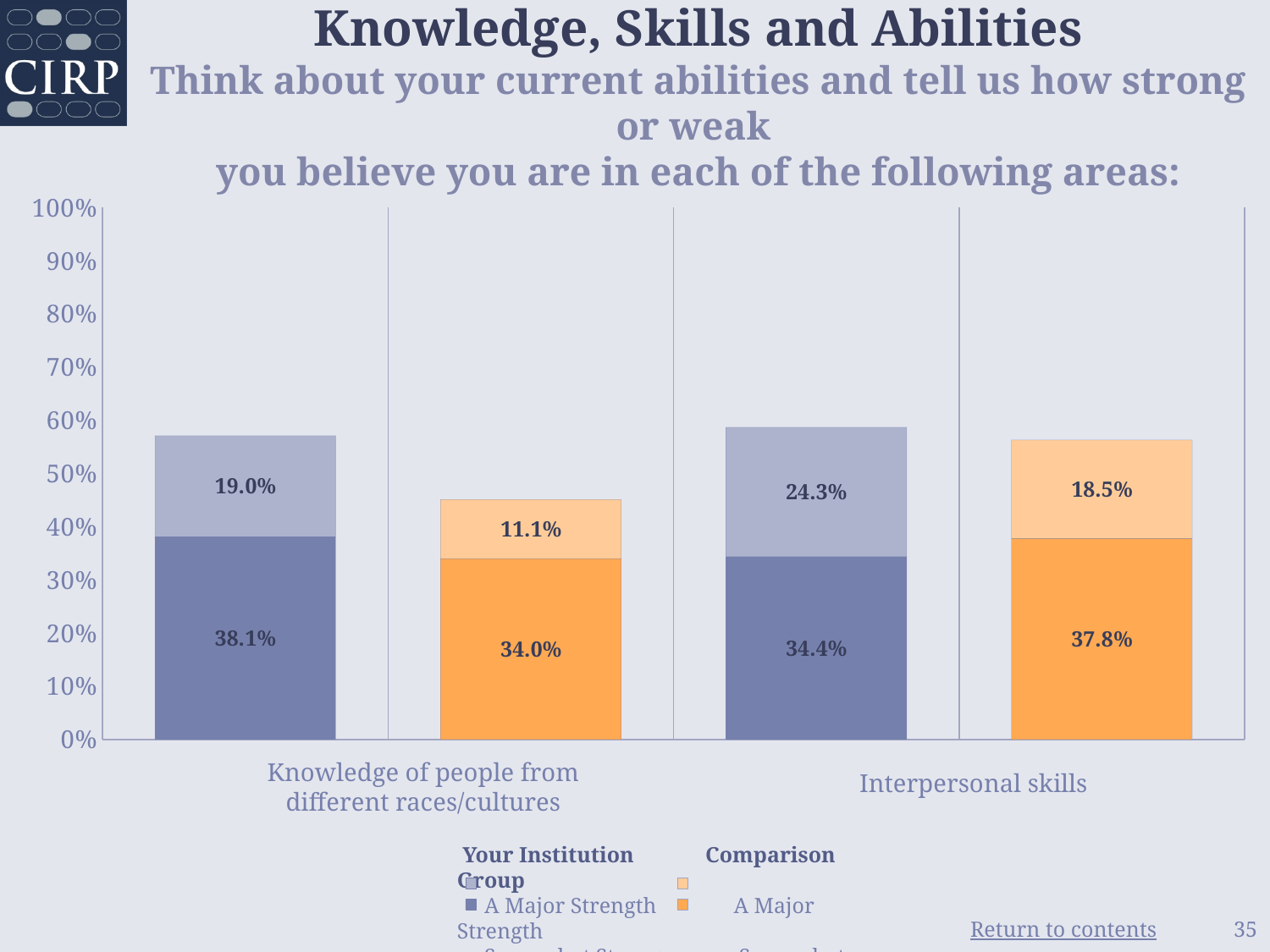
What is the difference between the 'A Major Strength' values for Your Institution and the Comparison Group on Knowledge of people from different races/cultures? 4.1% What type of chart is shown on the slide? Stacked bar chart Is the total height of the Comparison Group bar for Knowledge of people from different races/cultures greater or less than 50%? less What is the 'A Major Strength' value for Your Institution on Knowledge of people from different races/cultures? 38.1% For Interpersonal skills, which has the larger 'A Major Strength' value: Your Institution or the Comparison Group? Comparison Group What is the total height of the Your Institution stacked bar for Knowledge of people from different races/cultures? 57.1% What is the total height of the Comparison Group stacked bar for Interpersonal skills? 56.3% Which stacked bar has the lowest total height? Comparison Group, Knowledge of people from different races/cultures What is the 'A Major Strength' value for the Comparison Group on Interpersonal skills? 37.8% How many categories are shown on the x axis? 2 What is the value of the upper (lighter) segment of the Your Institution bar for Interpersonal skills? 24.3% What is the value of the upper (lighter) segment of the Comparison Group bar for Knowledge of people from different races/cultures? 11.1%